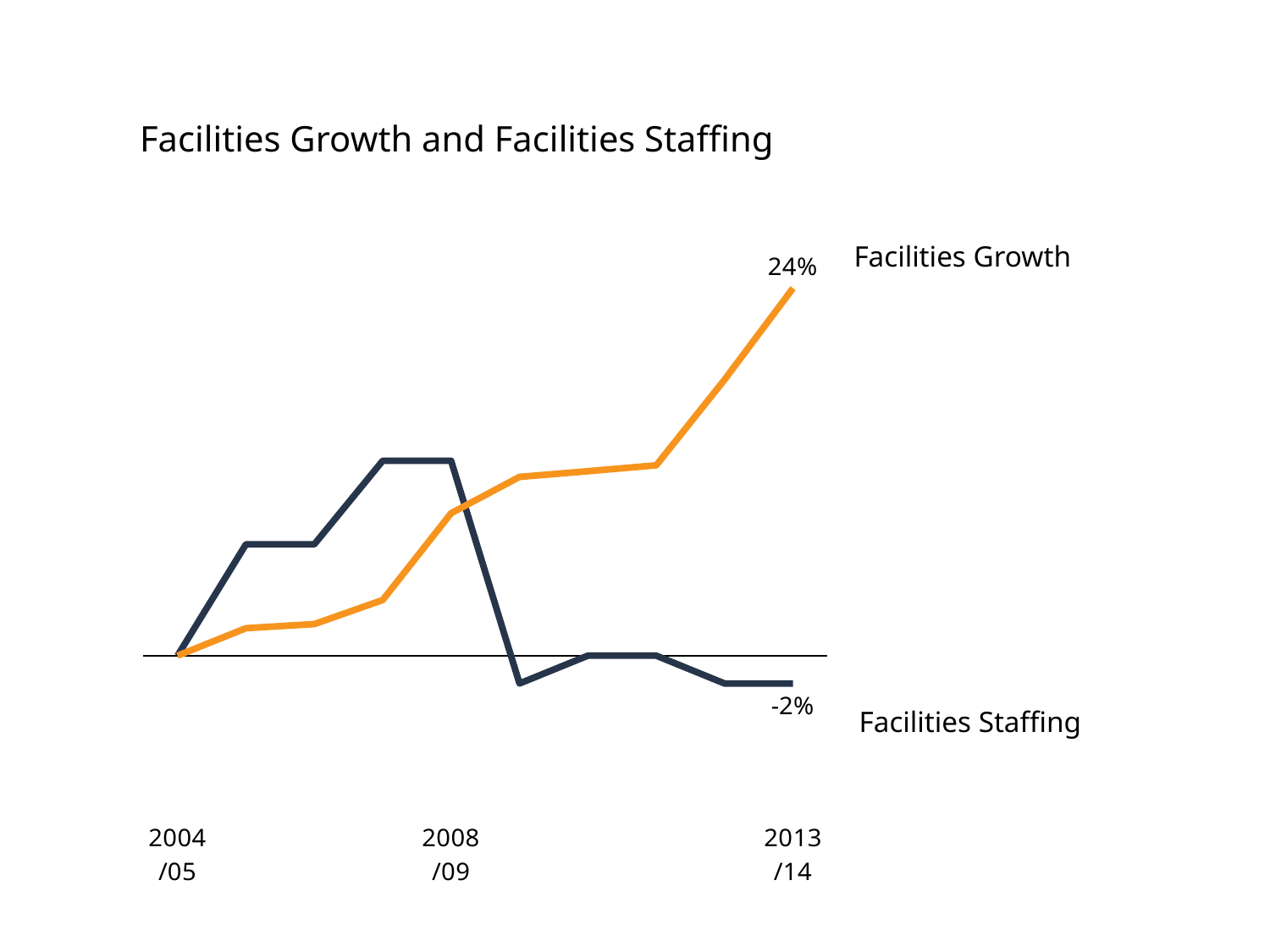
What is the first period labelled on the x axis? 2004/05 What is the value of Facilities Growth in 2013/14? 24% Does the Facilities Growth line rise or fall overall from 2004/05 to 2013/14? Rises What is the value of Facilities Staffing in 2013/14? -2% Is the value for Facilities Staffing in 2013/14 greater or less than 0? less What colour is the Facilities Growth line? Orange What is the difference between Facilities Growth and Facilities Staffing in 2013/14? 26 percentage points What kind of chart is shown on the slide? Line chart What is the title of the chart? Facilities Growth and Facilities Staffing Which series reaches the highest value on the chart? Facilities Growth How many series are plotted on the chart? 2 Which series has the higher value in 2013/14, Facilities Growth or Facilities Staffing? Facilities Growth